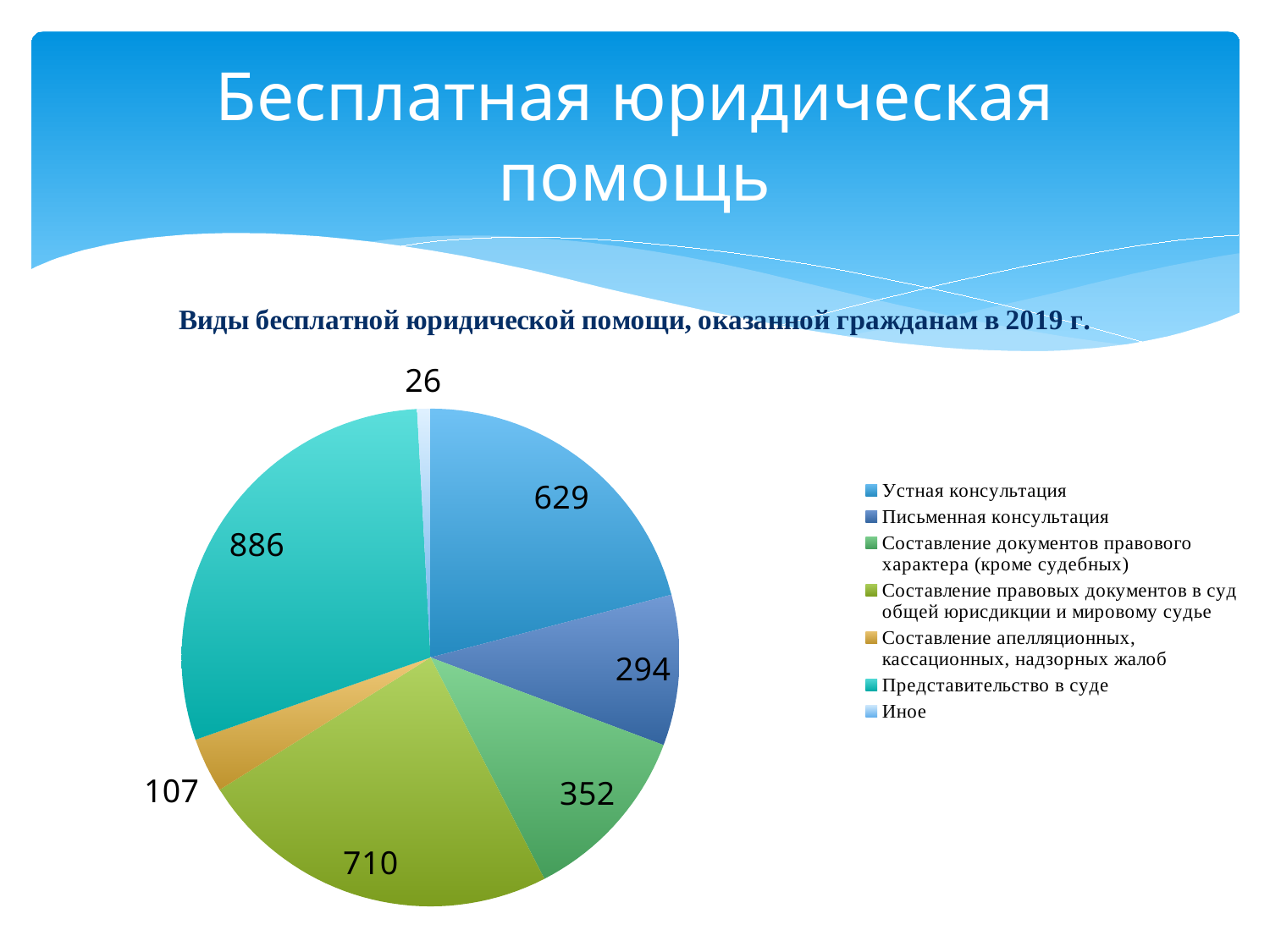
What type of chart is shown on the slide? Pie chart What is the value for Представительство в суде? 886 What is the difference between the values for Представительство в суде and Составление правовых документов в суд общей юрисдикции и мировому судье? 176 Which category has the largest slice of the pie? Представительство в суде Which is larger: Письменная консультация or Составление документов правового характера (кроме судебных)? Составление документов правового характера (кроме судебных) What is the total of all slices in the pie chart? 3004 Which category has the smallest slice of the pie? Иное What is the value for Иное? 26 What is the title of the chart? Виды бесплатной юридической помощи, оказанной гражданам в 2019 г. How many categories does the pie chart have? 7 What is the value for Устная консультация? 629 What is the value for Составление апелляционных, кассационных, надзорных жалоб? 107